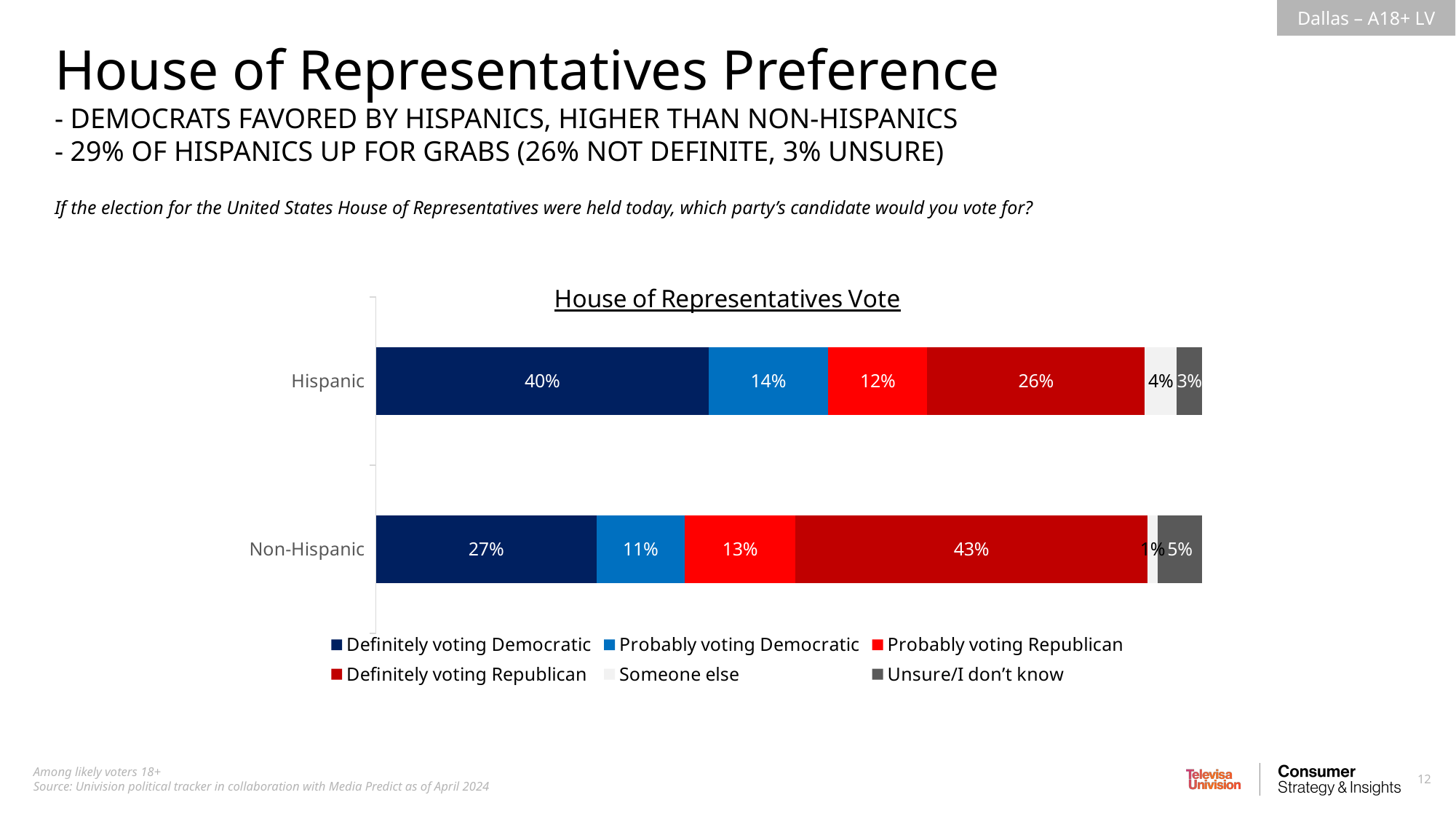
What is the difference between the Non-Hispanic and Hispanic shares definitely voting Republican? 17% How many groups (categories) are shown on the chart? 2 What is the difference between the Hispanic and Non-Hispanic shares probably voting Democratic? 3% Which response category is the smallest for Non-Hispanic respondents? Someone else What percentage of Non-Hispanic likely voters are definitely voting Republican? 43% How many series does the legend list? 6 What percentage of Hispanic respondents are probably voting Republican? 12% Which group has the higher share definitely voting Democratic, Hispanic or Non-Hispanic? Hispanic What type of chart is shown on the slide? Stacked bar chart What percentage of Non-Hispanic respondents answered Unsure/I don't know? 5% What percentage of Hispanic likely voters are definitely voting Democratic? 40% Which response category is the largest for Non-Hispanic respondents? Definitely voting Republican